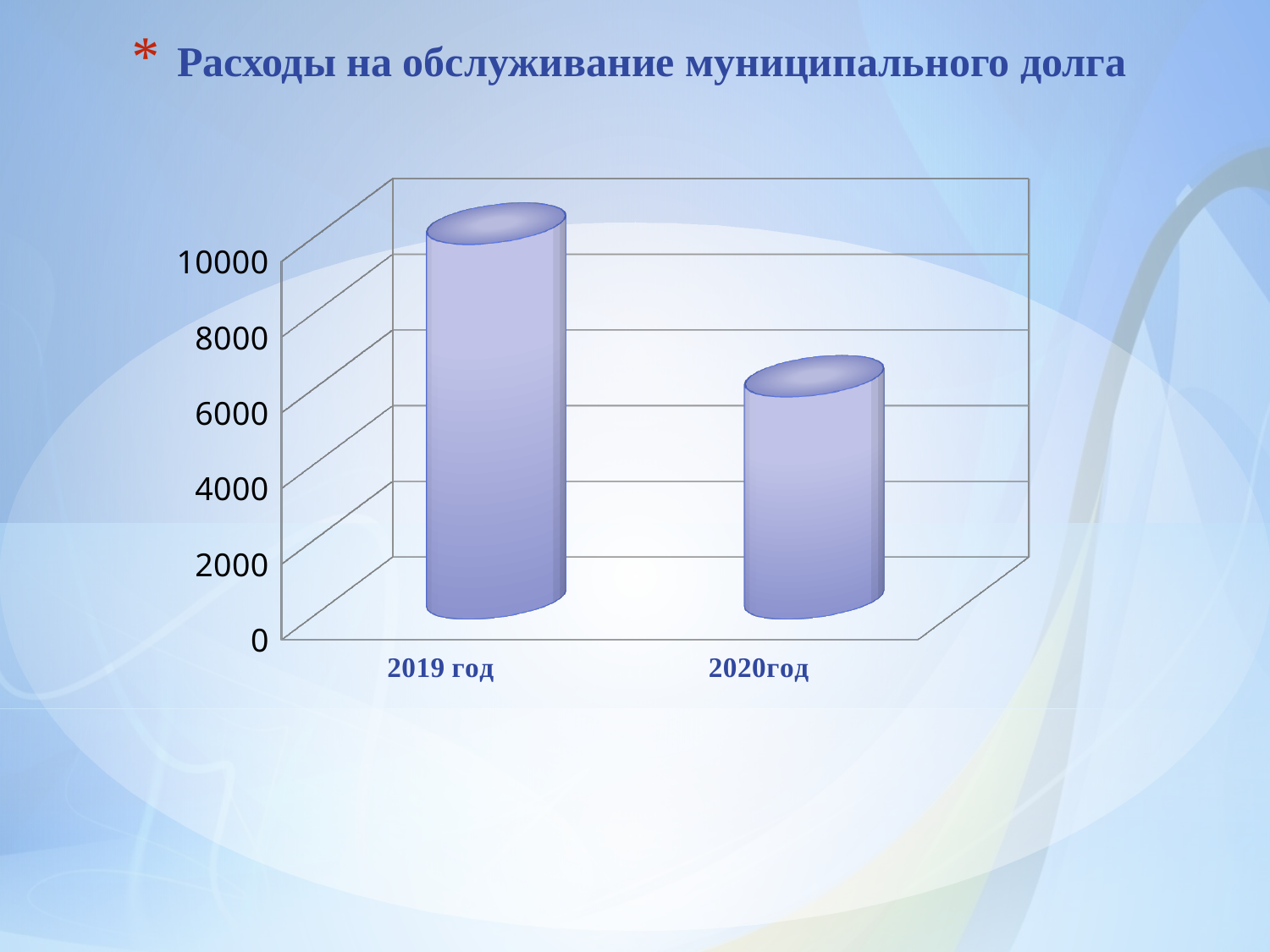
Do the values rise or fall from 2019 год to 2020год? fall Which is larger, the value for 2019 год or the value for 2020год? 2019 год Is the value for 2019 год greater or less than 8000? greater What kind of chart is shown on the slide? bar chart Which category has the lowest value? 2020год Is the value for 2019 год greater or less than 6000? greater Is the value for 2020год greater or less than 8000? less What is the title of the slide's chart? Расходы на обслуживание муниципального долга What is the highest tick value shown on the vertical axis? 10000 How many categories are plotted on the chart? 2 Which category has the highest value? 2019 год